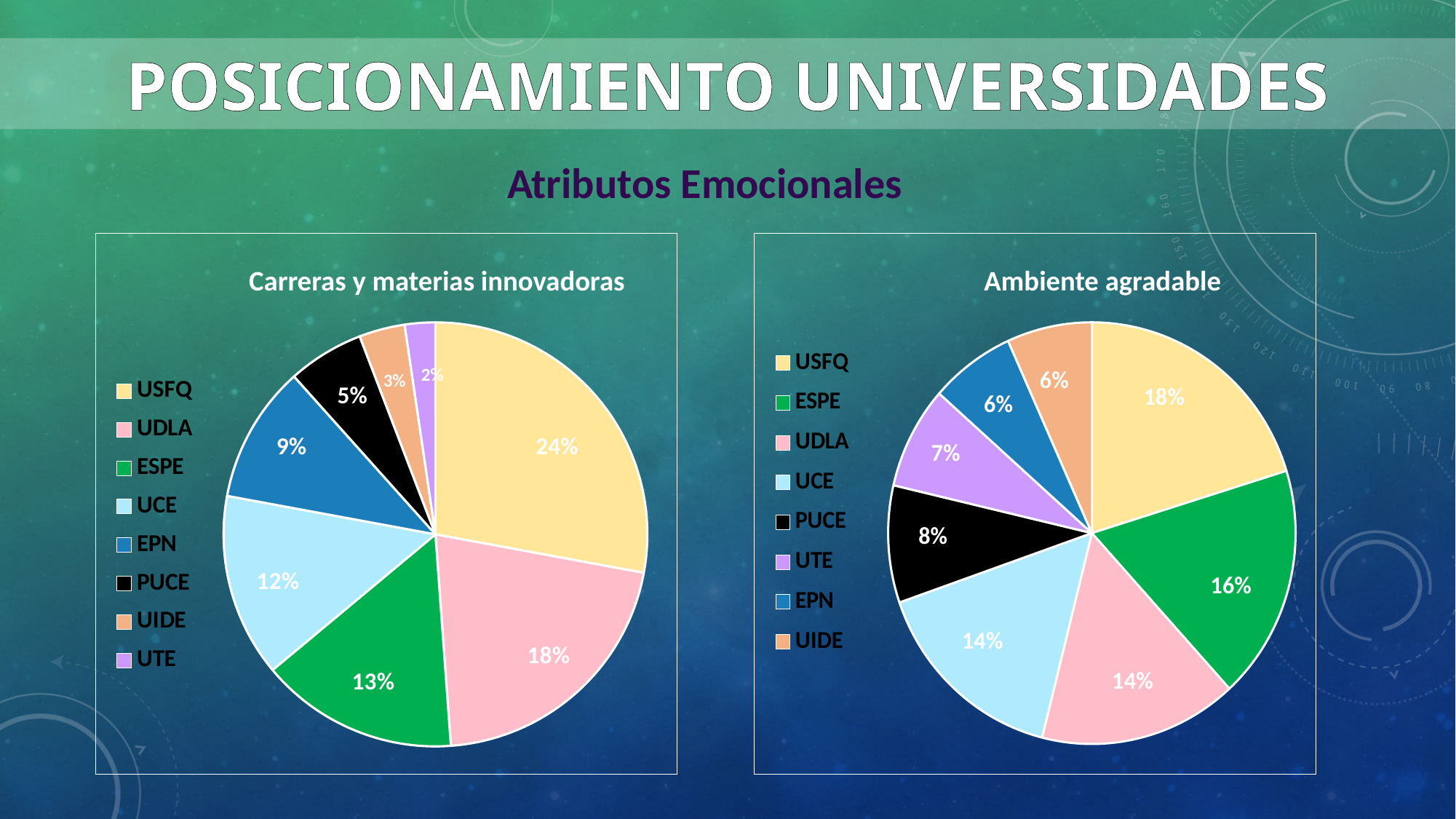
How many slices does the 'Ambiente agradable' pie chart have? 8 In the 'Carreras y materias innovadoras' chart, what is the difference between the shares of USFQ and UDLA? 6% What type of chart is 'Carreras y materias innovadoras'? Pie chart In the 'Carreras y materias innovadoras' chart, what share does EPN have? 9% In the 'Ambiente agradable' chart, what share does ESPE have? 16% In the 'Carreras y materias innovadoras' chart, which university has the smallest slice? UTE In the 'Carreras y materias innovadoras' chart, what share does USFQ have? 24% What is the title of the chart on the right side of the slide? Ambiente agradable In the 'Ambiente agradable' chart, which is larger, the share for PUCE or the share for UTE? PUCE In the 'Ambiente agradable' chart, what share does UIDE have? 6% In the 'Ambiente agradable' chart, which university has the largest slice? USFQ In the 'Carreras y materias innovadoras' chart, what is the combined share of UIDE and UTE? 5%